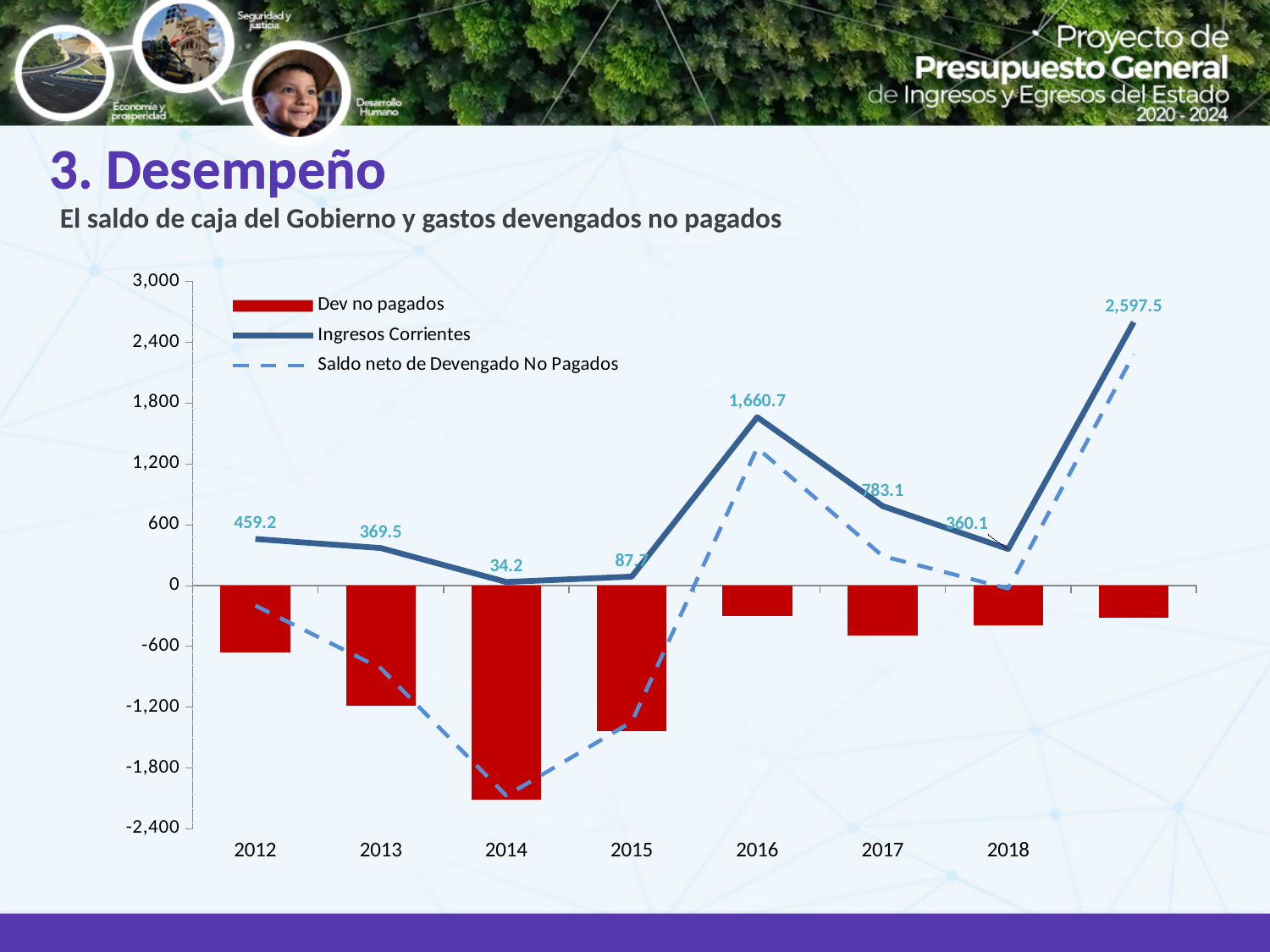
Is the Dev no pagados bar for 2016 greater or less than -600? greater Which year has the lowest value of Ingresos Corrientes? 2014 What is the value of Ingresos Corrientes in 2018? 360.1 Does Ingresos Corrientes rise or fall from 2012 to 2014? fall How many series does the legend list? 3 What is the difference between Ingresos Corrientes in 2012 and 2013? 89.7 What is the difference between Ingresos Corrientes in 2016 and 2017? 877.6 Which year has the larger value of Ingresos Corrientes, 2016 or 2017? 2016 What is the value of Ingresos Corrientes in 2016? 1,660.7 Is the Dev no pagados bar for 2014 greater or less than -1,800? less What is the value of Ingresos Corrientes in 2012? 459.2 What is the highest data label shown for Ingresos Corrientes? 2,597.5